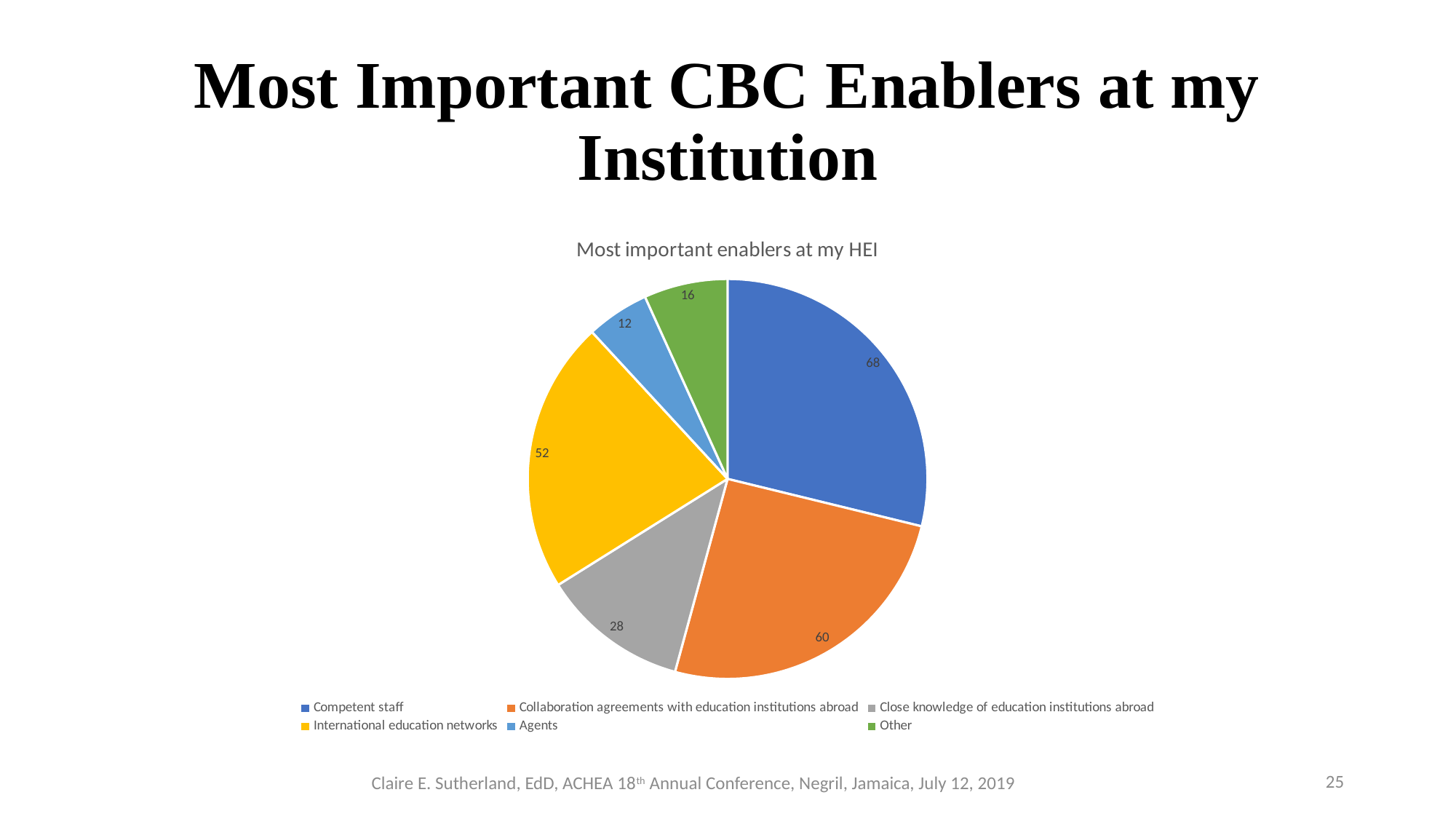
What type of chart is shown on the slide? Pie chart What is the value for Close knowledge of education institutions abroad? 28 What is the value for Agents in the pie chart? 12 What is the value for International education networks in the pie chart? 52 What is the value for Competent staff in the pie chart? 68 What is the difference between the values for Competent staff and Collaboration agreements with education institutions abroad? 8 Which category has the smallest slice of the pie chart? Agents What is the title of the chart on the slide? Most important enablers at my HEI Which is larger: International education networks or Close knowledge of education institutions abroad? International education networks Which category has the largest slice of the pie chart? Competent staff How many categories does the pie chart show? 6 What is the total of all the values in the pie chart? 236